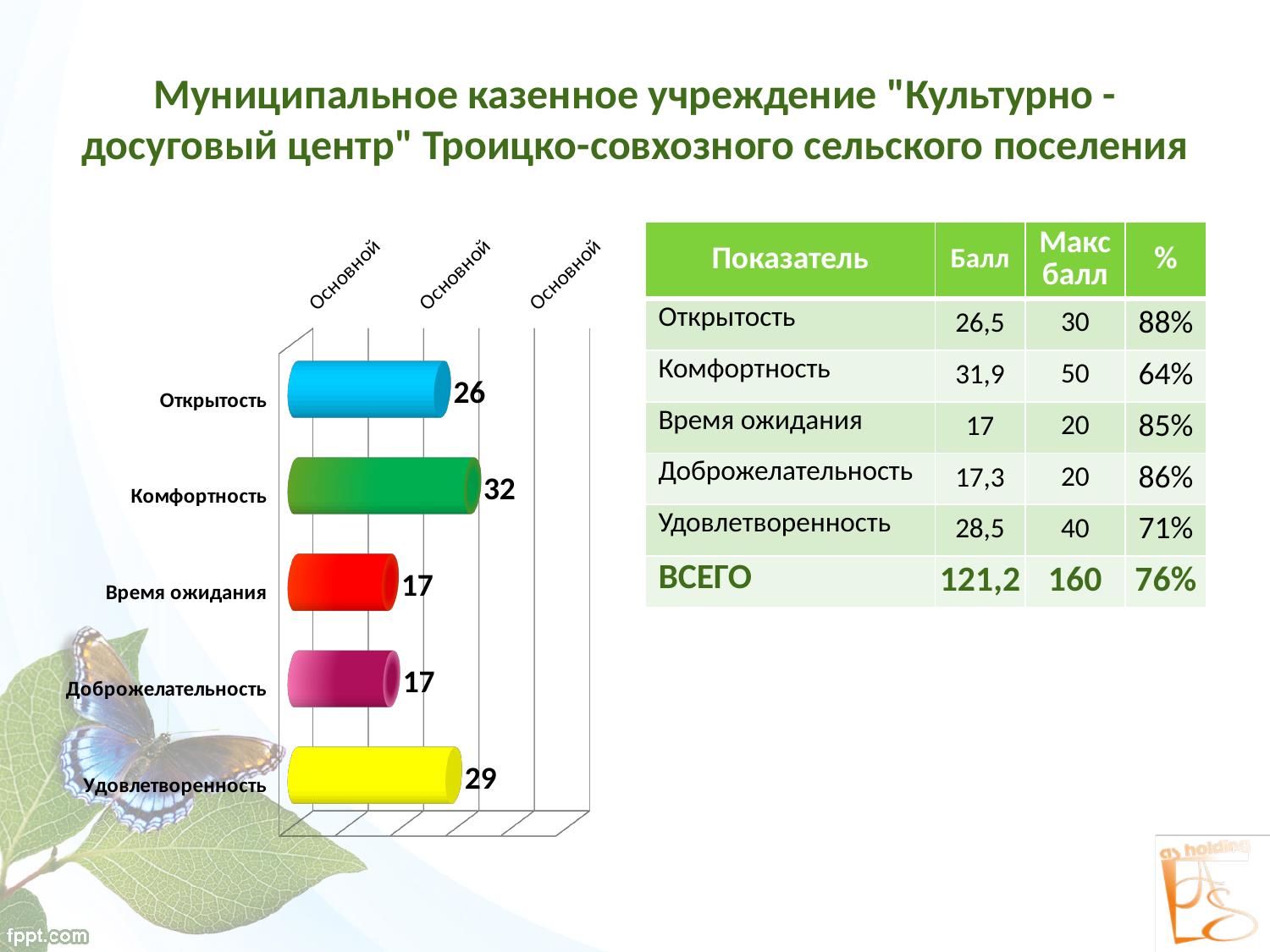
What is the difference between the values for Комфортность and Открытость on the chart? 6 What is the difference between the values for Удовлетворенность and Доброжелательность on the chart? 12 Which is larger on the chart, the value for Удовлетворенность or the value for Открытость? Удовлетворенность What value is shown for Открытость on the chart? 26 What value is shown for Время ожидания on the chart? 17 What kind of chart is shown on the slide? Bar chart Which is larger on the chart, the value for Комфортность or the value for Время ожидания? Комфортность What value is shown for Комфортность on the chart? 32 What colour is the bar for Время ожидания on the chart? Red What value is shown for Удовлетворенность on the chart? 29 Which category has the highest value on the chart? Комфортность How many categories are plotted on the chart? 5